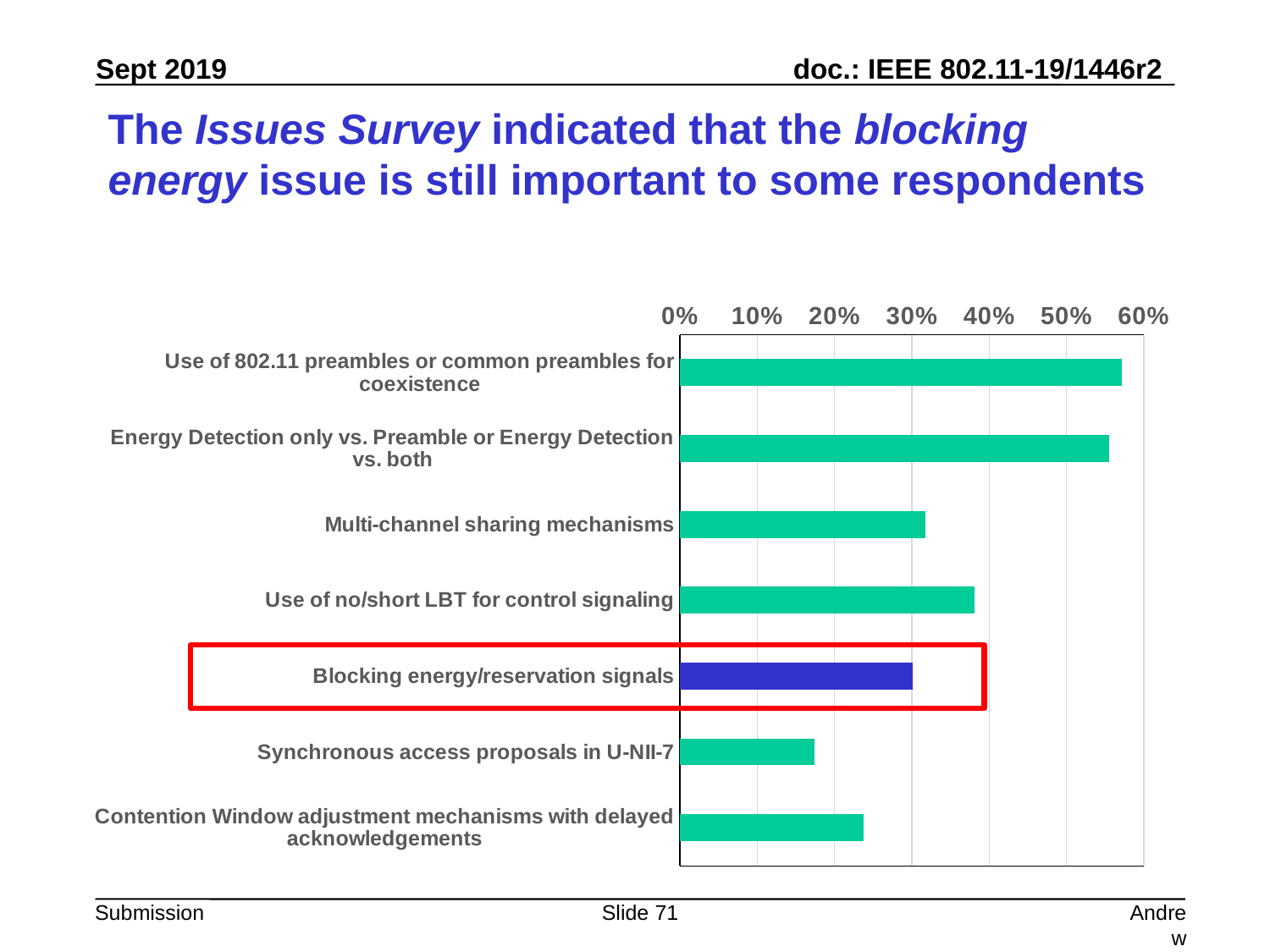
Is the value for 'Synchronous access proposals in U-NII-7' greater or less than 20%? less Is the value for 'Use of no/short LBT for control signaling' greater or less than 30%? greater What kind of chart is shown on the slide? bar chart Which category has the lowest value in the chart? Synchronous access proposals in U-NII-7 Is the value for 'Use of 802.11 preambles or common preambles for coexistence' greater or less than 50%? greater How many categories are plotted in the chart? 7 Which category's bar is drawn in a different colour (blue) and outlined with a red box? Blocking energy/reservation signals What is the highest value shown on the chart's percentage axis? 60% Which has a larger value: 'Multi-channel sharing mechanisms' or 'Use of no/short LBT for control signaling'? Use of no/short LBT for control signaling Which has a larger value: 'Synchronous access proposals in U-NII-7' or 'Contention Window adjustment mechanisms with delayed acknowledgements'? Contention Window adjustment mechanisms with delayed acknowledgements